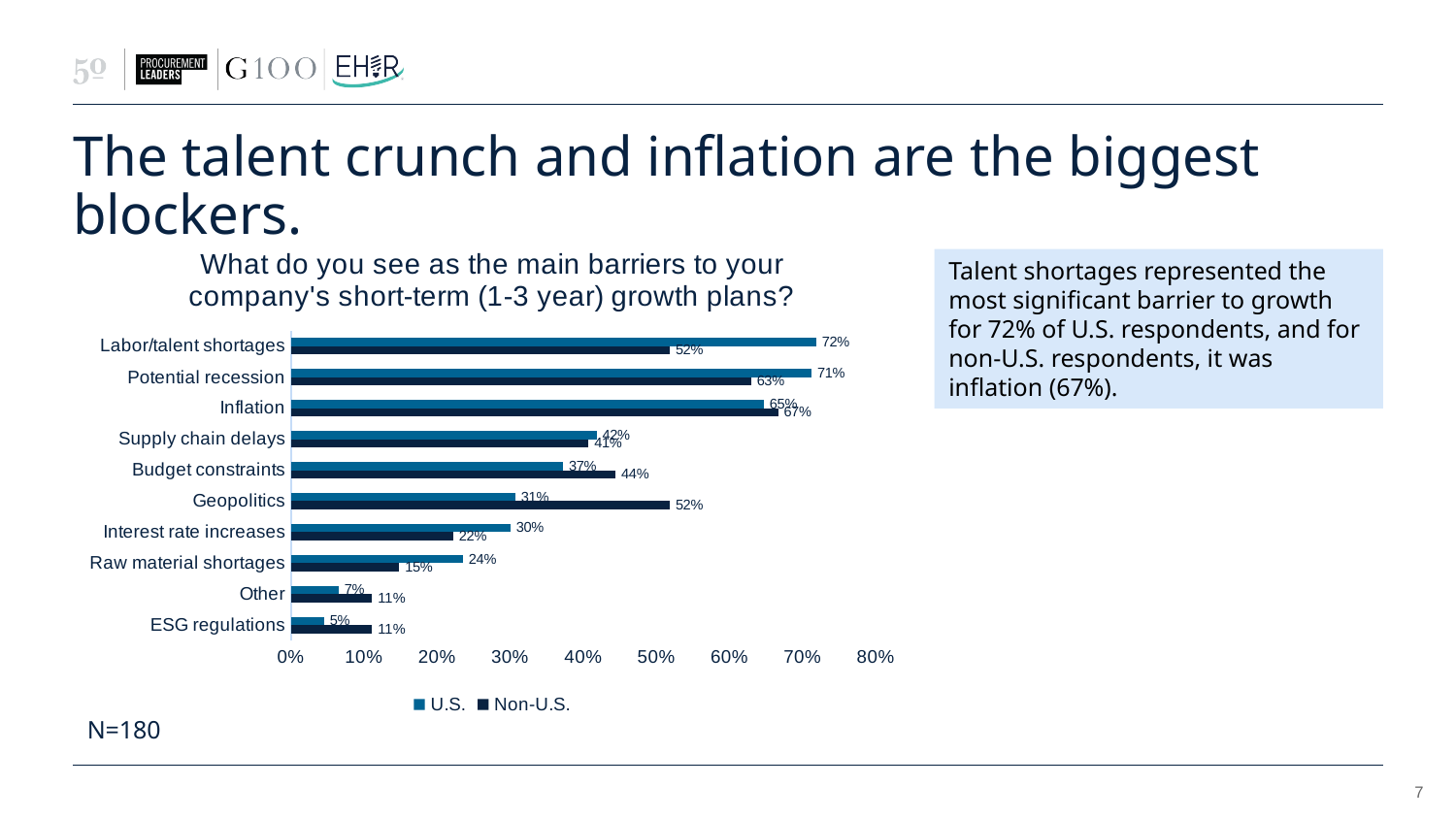
What kind of chart is shown on the slide? Bar chart What is the sample size noted below the chart? N=180 Which category has the highest U.S. value? Labor/talent shortages What is the Non-U.S. value for Inflation? 67% What is the U.S. value for Labor/talent shortages? 72% What is the difference between the U.S. and Non-U.S. values for Labor/talent shortages? 20% How many series does the legend list? 2 How many categories are shown on the chart? 10 Which category has the lowest U.S. value? ESG regulations What is the difference between the Non-U.S. and U.S. values for Geopolitics? 21% For Budget constraints, which is larger: the U.S. value or the Non-U.S. value? Non-U.S. What is the Non-U.S. value for Geopolitics? 52%